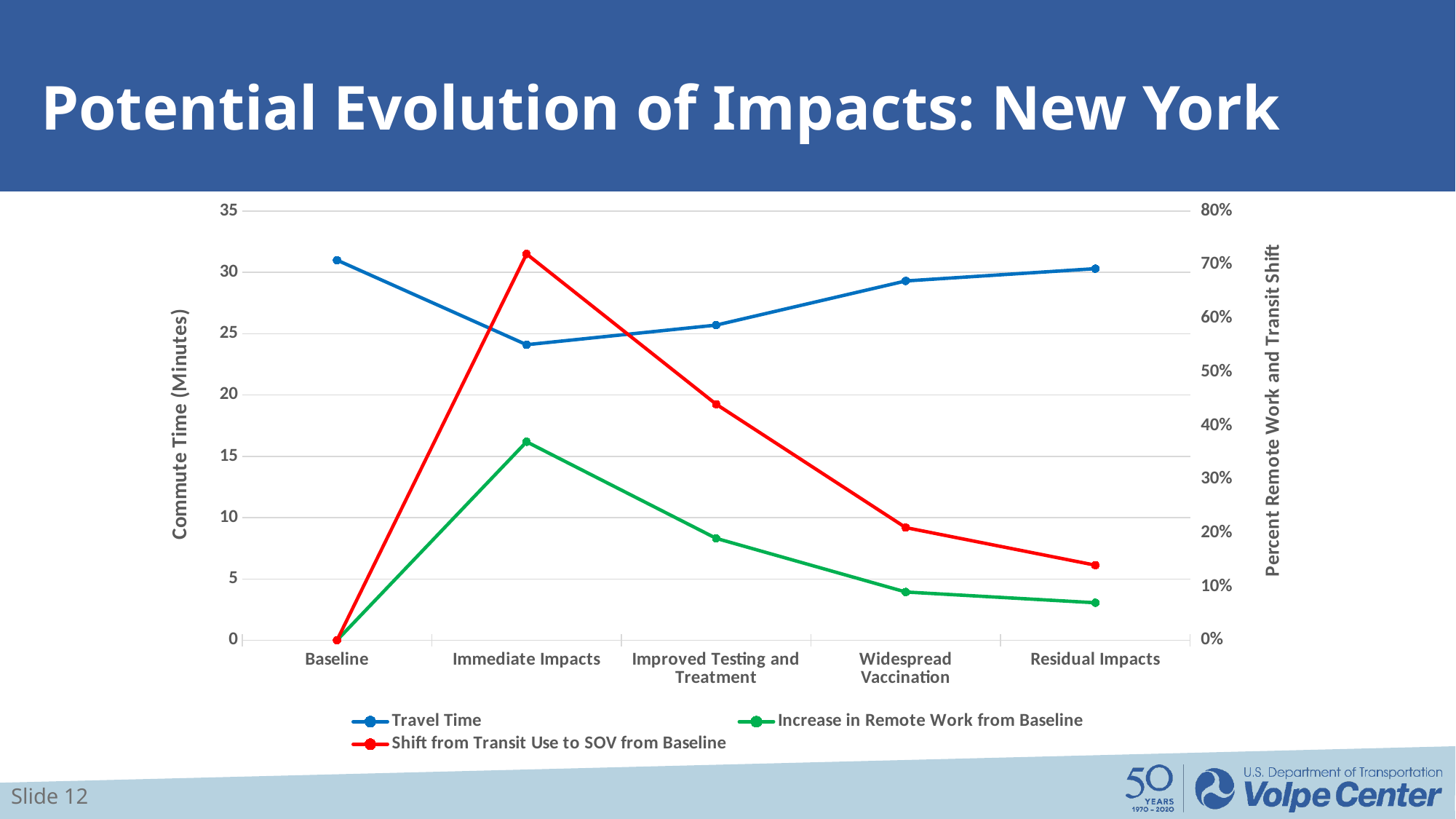
How many categories are shown along the x axis? 5 Is the Travel Time value at Baseline greater or less than 30? greater Is the Shift from Transit Use to SOV from Baseline value at Immediate Impacts greater or less than 70%? greater What type of chart is shown on the slide? line chart What is the value of Increase in Remote Work from Baseline at Baseline? 0% At which category is Shift from Transit Use to SOV from Baseline highest? Immediate Impacts From Immediate Impacts to Residual Impacts, does Increase in Remote Work from Baseline rise or fall? fall How many series does the legend list? 3 What is the title of the left vertical axis? Commute Time (Minutes) At which category is Travel Time lowest? Immediate Impacts Which is larger at Improved Testing and Treatment: Shift from Transit Use to SOV from Baseline or Increase in Remote Work from Baseline? Shift from Transit Use to SOV from Baseline What is the value of Shift from Transit Use to SOV from Baseline at Baseline? 0%